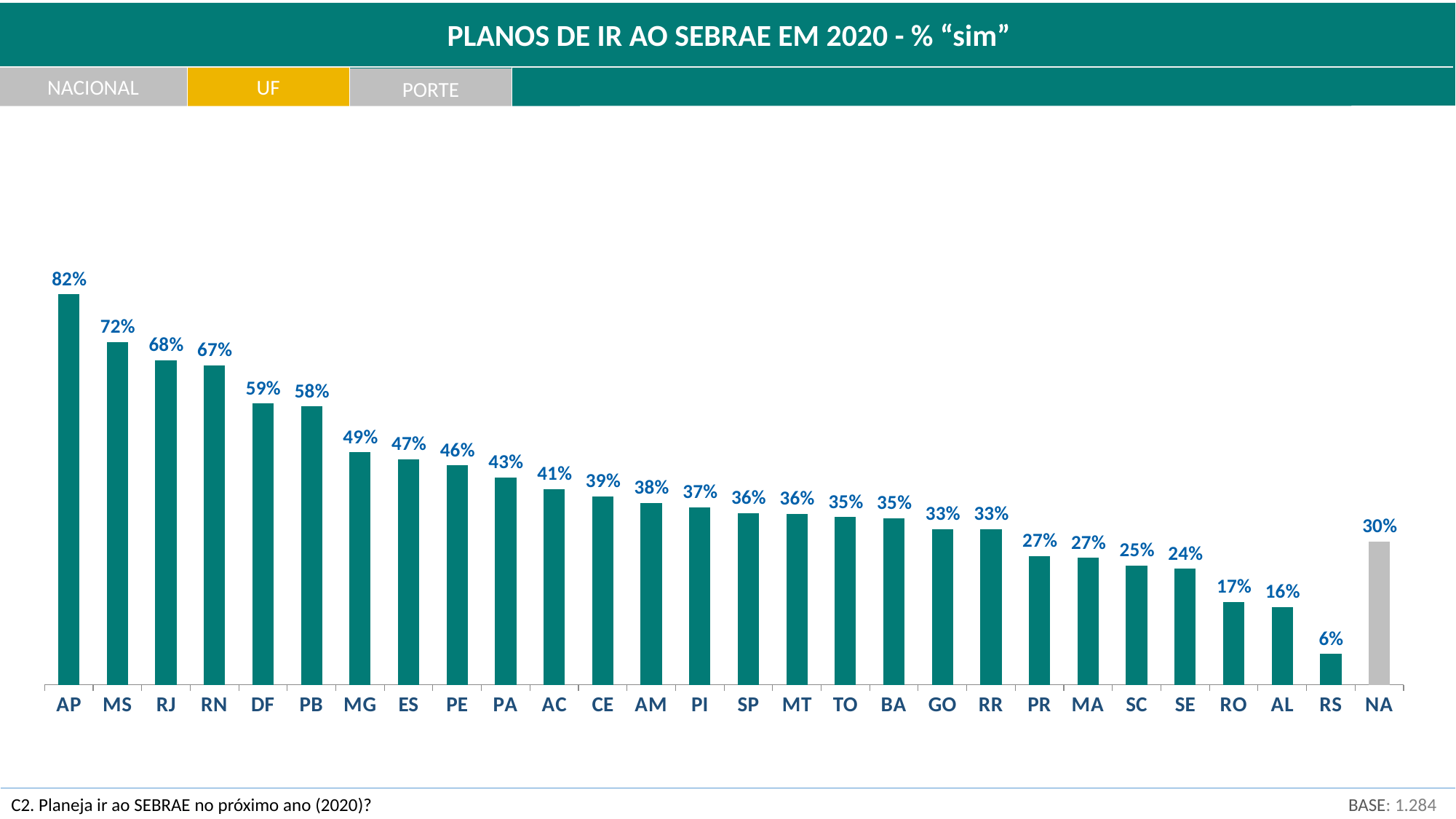
What is the value for SP? 36% What kind of chart is this? Bar chart What is the difference between the values for AP and MS? 10% Which is larger, the value for DF or the value for MG? DF What is the value for NA? 30% How many categories are shown on the x axis? 28 Do the values for the UF bars generally rise or fall from left to right (AP to RS)? Fall What is the title of the chart? PLANOS DE IR AO SEBRAE EM 2020 - % "sim" What is the value for RO? 17% Which category has the highest value? AP Which category has the lowest value? RS What is the difference between the values for NA and RS? 24%